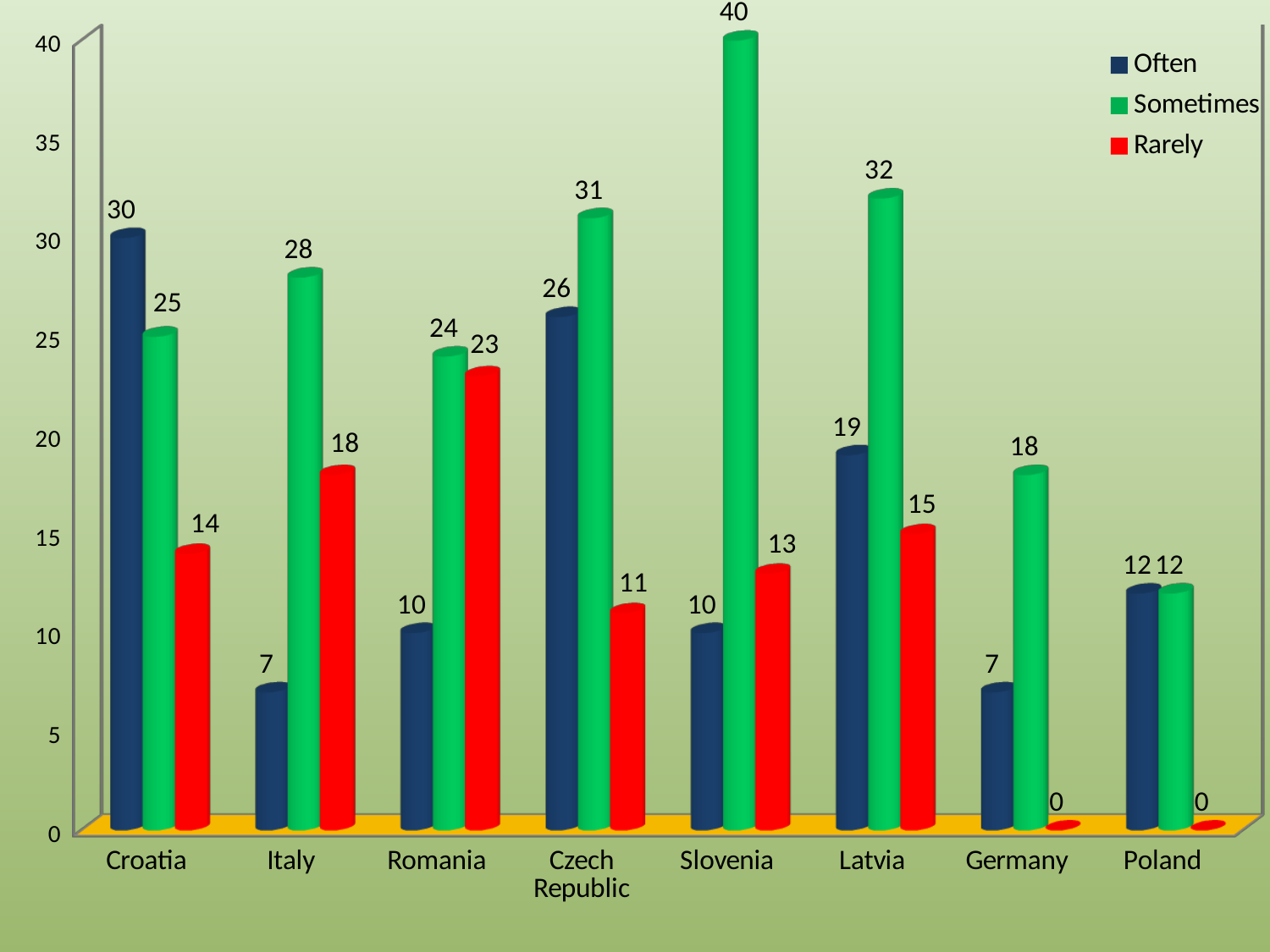
Which country has the highest value for Sometimes? Slovenia Which country has the lowest value for Often? Italy and Germany Which colour represents the Rarely series? red What is the value for Sometimes in Slovenia? 40 What kind of chart is this? bar chart What is the value for Rarely in Romania? 23 What is the difference between the Sometimes and Rarely values for Latvia? 17 Which is larger in the Czech Republic, the Often value or the Sometimes value? Sometimes How many countries are shown on the x axis? 8 How many series does the legend list? 3 What is the value for Often in Croatia? 30 What is the total of the three values for Poland? 24